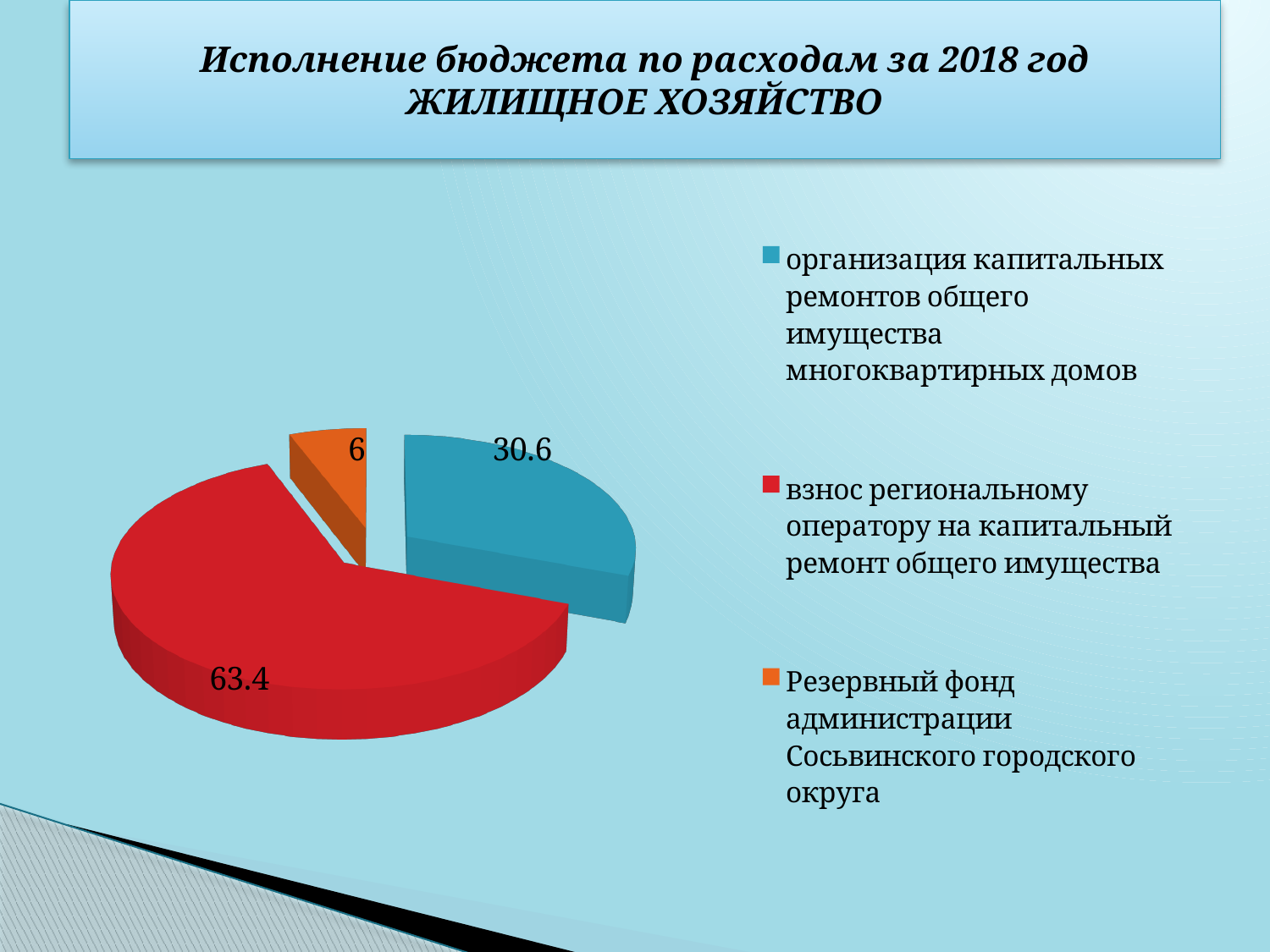
What kind of chart is shown on the slide? pie chart What is the value for "взнос региональному оператору на капитальный ремонт общего имущества"? 63.4 How many entries does the legend list? 3 What is the value for "организация капитальных ремонтов общего имущества многоквартирных домов"? 30.6 What is the difference between the values for "взнос региональному оператору на капитальный ремонт общего имущества" and "организация капитальных ремонтов общего имущества многоквартирных домов"? 32.8 How many slices does the pie chart have? 3 Which category has the smallest slice of the pie? Резервный фонд администрации Сосьвинского городского округа Which is larger: the value for "организация капитальных ремонтов общего имущества многоквартирных домов" or the value for "Резервный фонд администрации Сосьвинского городского округа"? организация капитальных ремонтов общего имущества многоквартирных домов What is the difference between the values for "организация капитальных ремонтов общего имущества многоквартирных домов" and "Резервный фонд администрации Сосьвинского городского округа"? 24.6 Which category has the largest slice of the pie? взнос региональному оператору на капитальный ремонт общего имущества What is the value for "Резервный фонд администрации Сосьвинского городского округа"? 6 What colour is the slice for "Резервный фонд администрации Сосьвинского городского округа"? orange